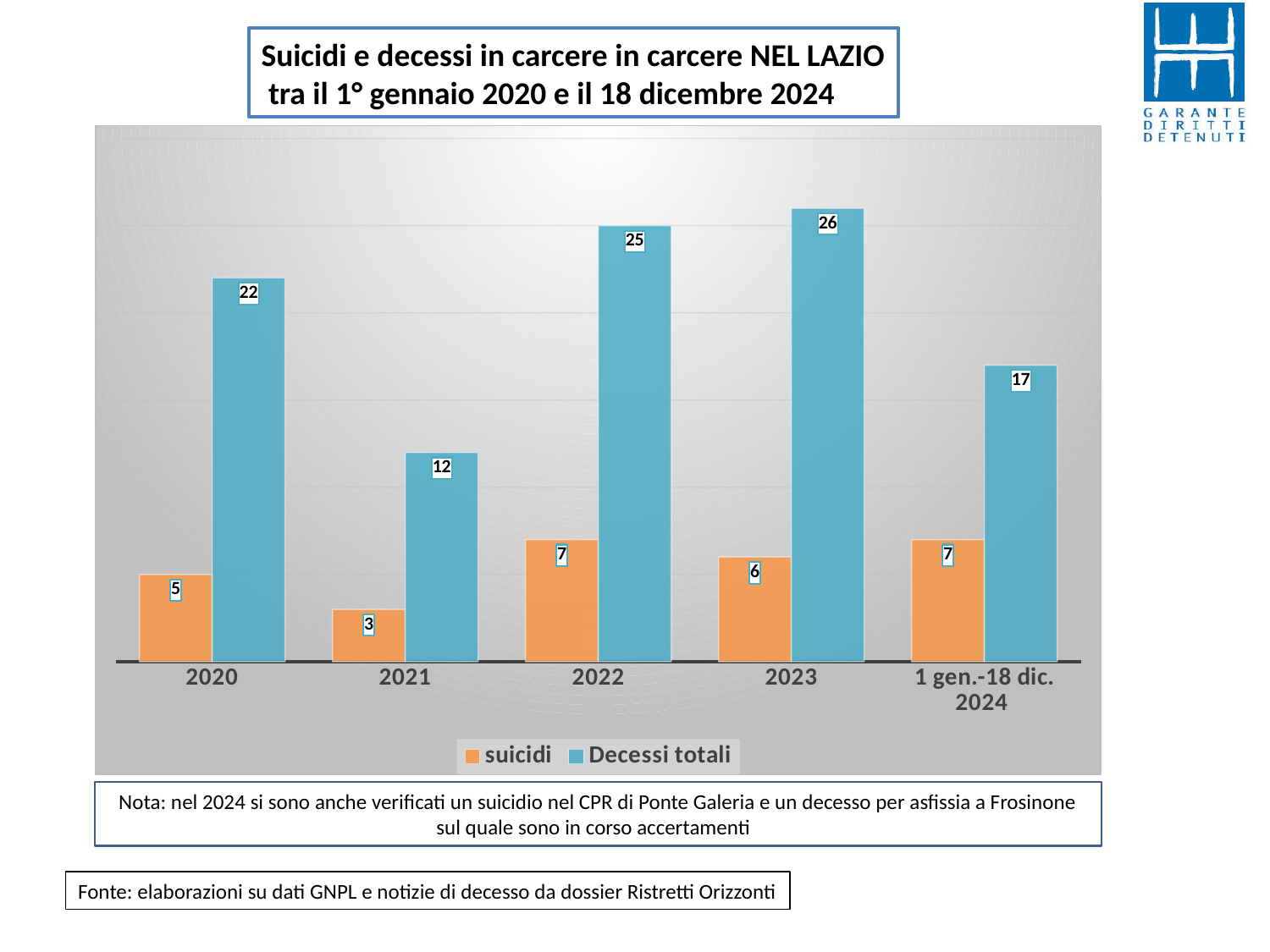
What is the difference between 'Decessi totali' in 2020 and 2021? 10 Which is larger: 'suicidi' in 2022 or 'suicidi' in 2023? 2022 What is the value of 'suicidi' for 2021? 3 What is the value of 'Decessi totali' for the period '1 gen.-18 dic. 2024'? 17 Which colour represents the 'suicidi' series? orange What kind of chart is shown on the slide? bar chart Which year has the highest value for 'Decessi totali'? 2023 How many categories are shown on the x axis? 5 Which category has the lowest value for 'suicidi'? 2021 What is the difference between 'Decessi totali' and 'suicidi' in 2023? 20 What is the value of 'Decessi totali' for 2022? 25 How many series does the legend list? 2